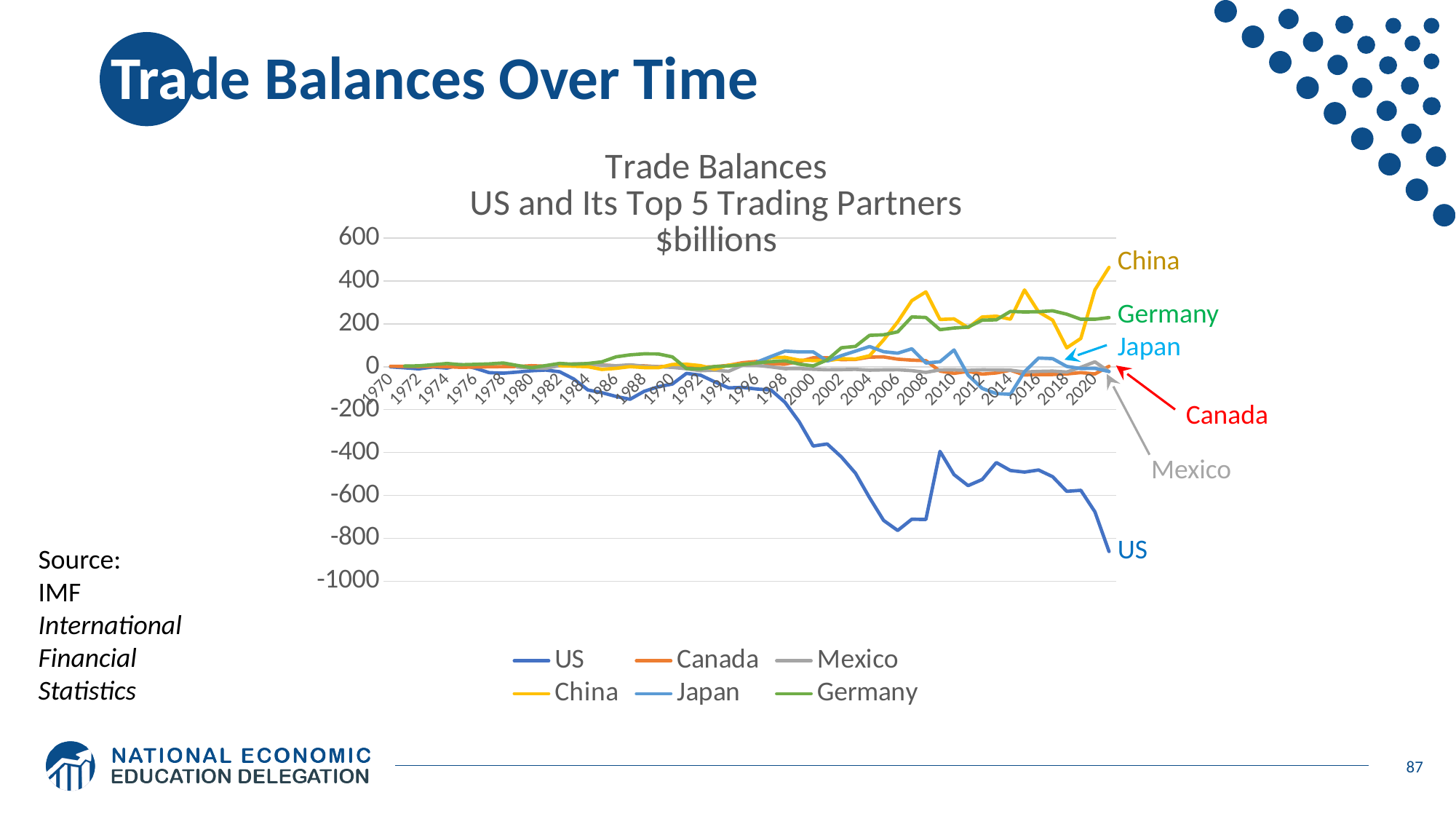
Is the value for the US in 2020 greater or less than -800? greater What kind of chart is shown on the slide? Line chart How many series does the legend list? 6 What unit is stated in the chart title? $billions In 2020, which is larger, the value for China or the value for Germany? China Which series has the highest value in 2020? China Is the value for China in 2008 greater or less than 200? greater Is the value for the US in 2006 greater or less than -600? less Does the US trade balance generally rise or fall from 1970 to 2020? Fall What is the title of the chart? Trade Balances US and Its Top 5 Trading Partners $billions Which series has the lowest value in 2020? US